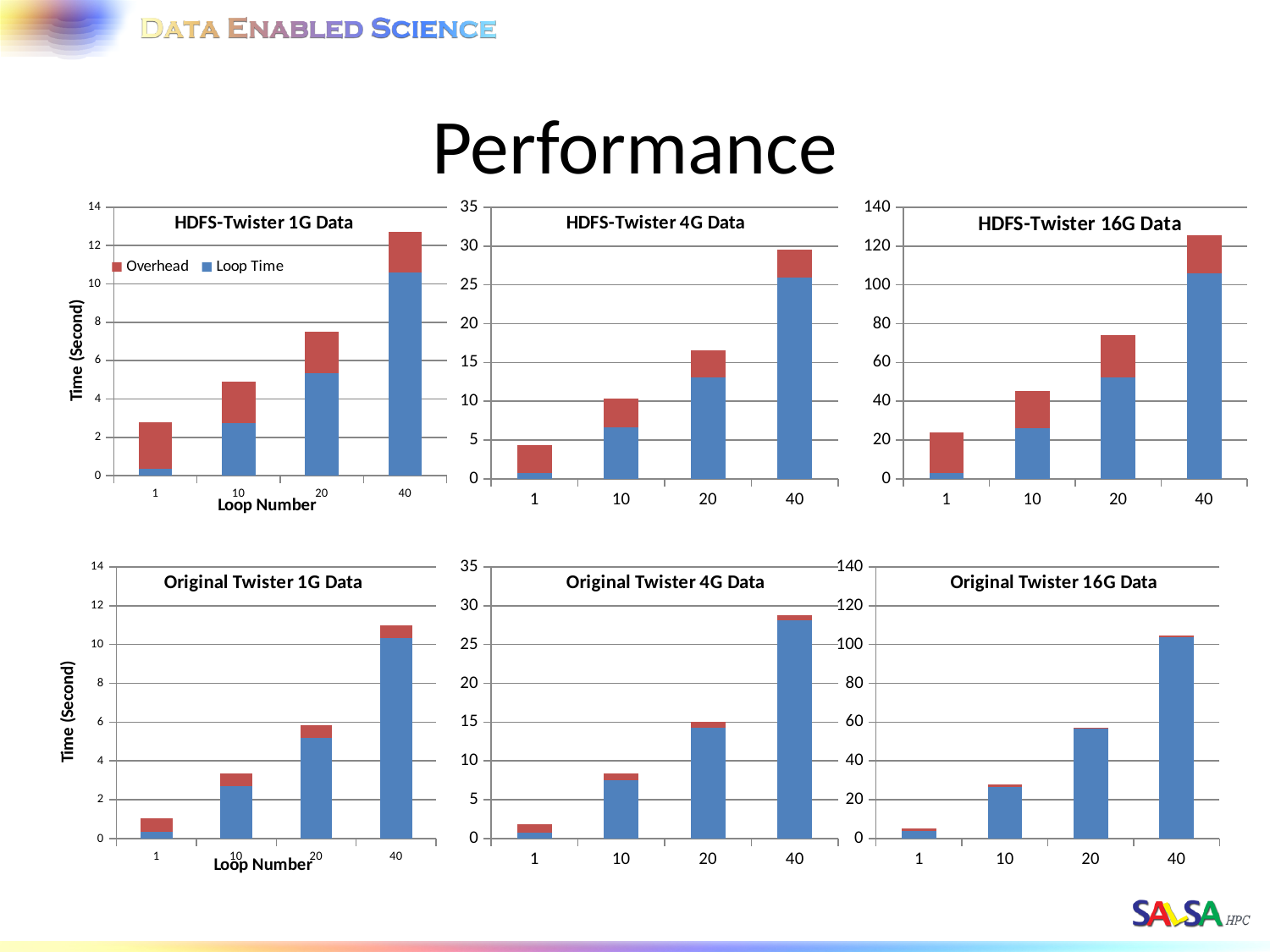
In the "HDFS-Twister 1G Data" chart, which has the taller bar: loop number 10 or loop number 20? 20 In the "Original Twister 4G Data" chart, which loop number has the shortest bar? 1 In the "HDFS-Twister 16G Data" chart, is the total bar height for loop number 20 greater or less than 60? greater What kind of chart is the "HDFS-Twister 1G Data" chart? Stacked bar chart In the "HDFS-Twister 4G Data" chart, is the total bar height for loop number 40 greater or less than 25? greater What are the two legend entries shown in the "HDFS-Twister 1G Data" chart? Overhead and Loop Time In the "Original Twister 16G Data" chart, do the bar heights rise or fall as the loop number increases? rise How many series does the legend in the "HDFS-Twister 1G Data" chart list? 2 How many loop numbers are plotted on the x axis of the "HDFS-Twister 4G Data" chart? 4 What is the y-axis label on the "Original Twister 1G Data" chart? Time (Second) In the "Original Twister 4G Data" chart, is the total bar height for loop number 10 greater or less than 10? less In the "HDFS-Twister 16G Data" chart, which loop number has the tallest bar? 40